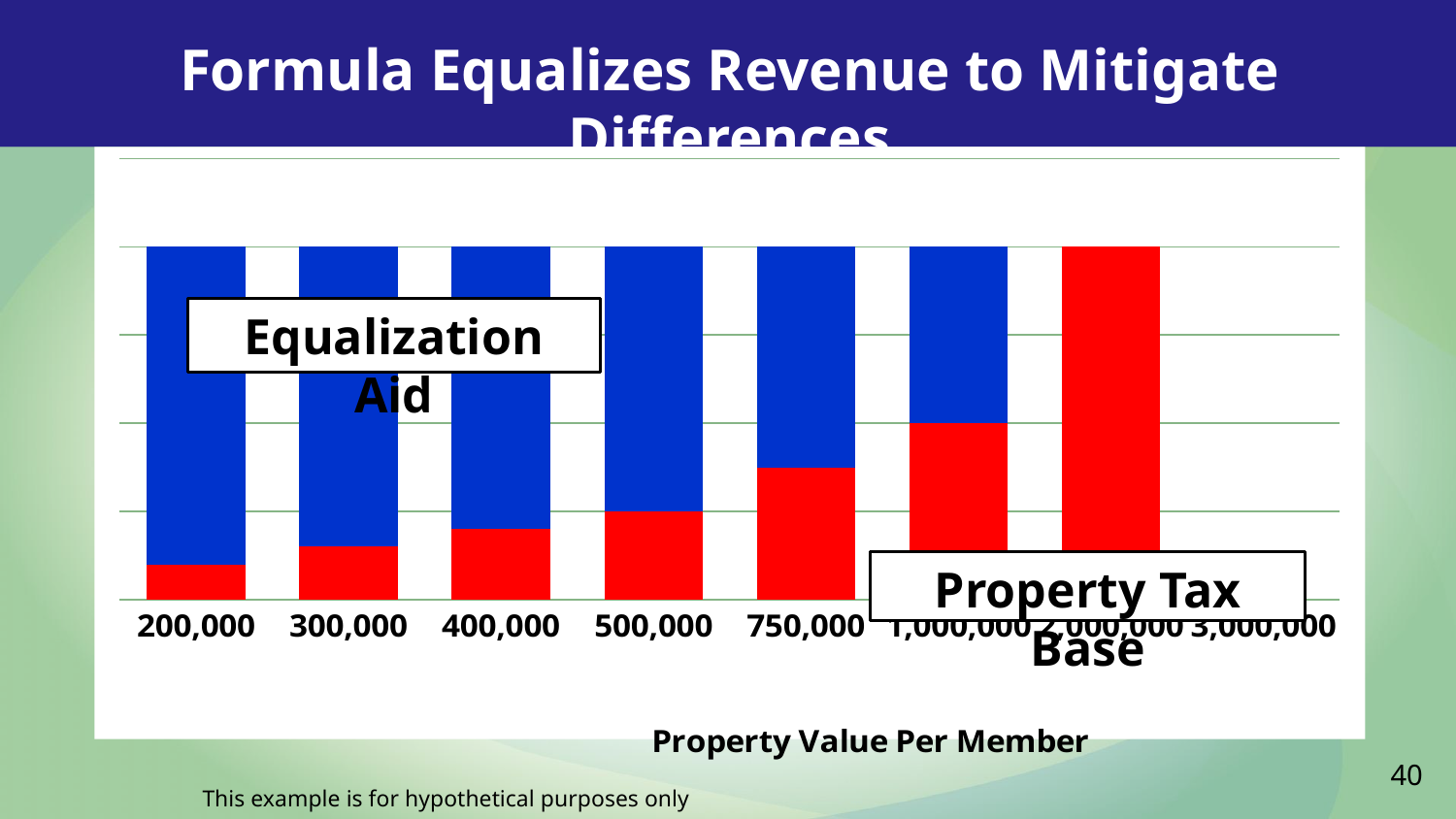
What kind of chart is shown on the slide? Stacked bar chart Which category receives no Equalization Aid? 2,000,000 Which colour represents Equalization Aid in the chart? Blue Which category has the largest Equalization Aid (blue) portion? 200,000 What is the title of the x axis? Property Value Per Member Is the Property Tax Base portion larger for 1,000,000 or for 500,000? 1,000,000 How many property value categories are shown along the x axis? 8 Which category has the smallest Property Tax Base (red) portion? 200,000 Does the Property Tax Base portion rise or fall as property value per member increases along the x axis? Rise How many series are shown in the chart? 2 Which category has the largest Property Tax Base (red) portion? 2,000,000 Is the Equalization Aid portion larger for 300,000 or for 750,000? 300,000